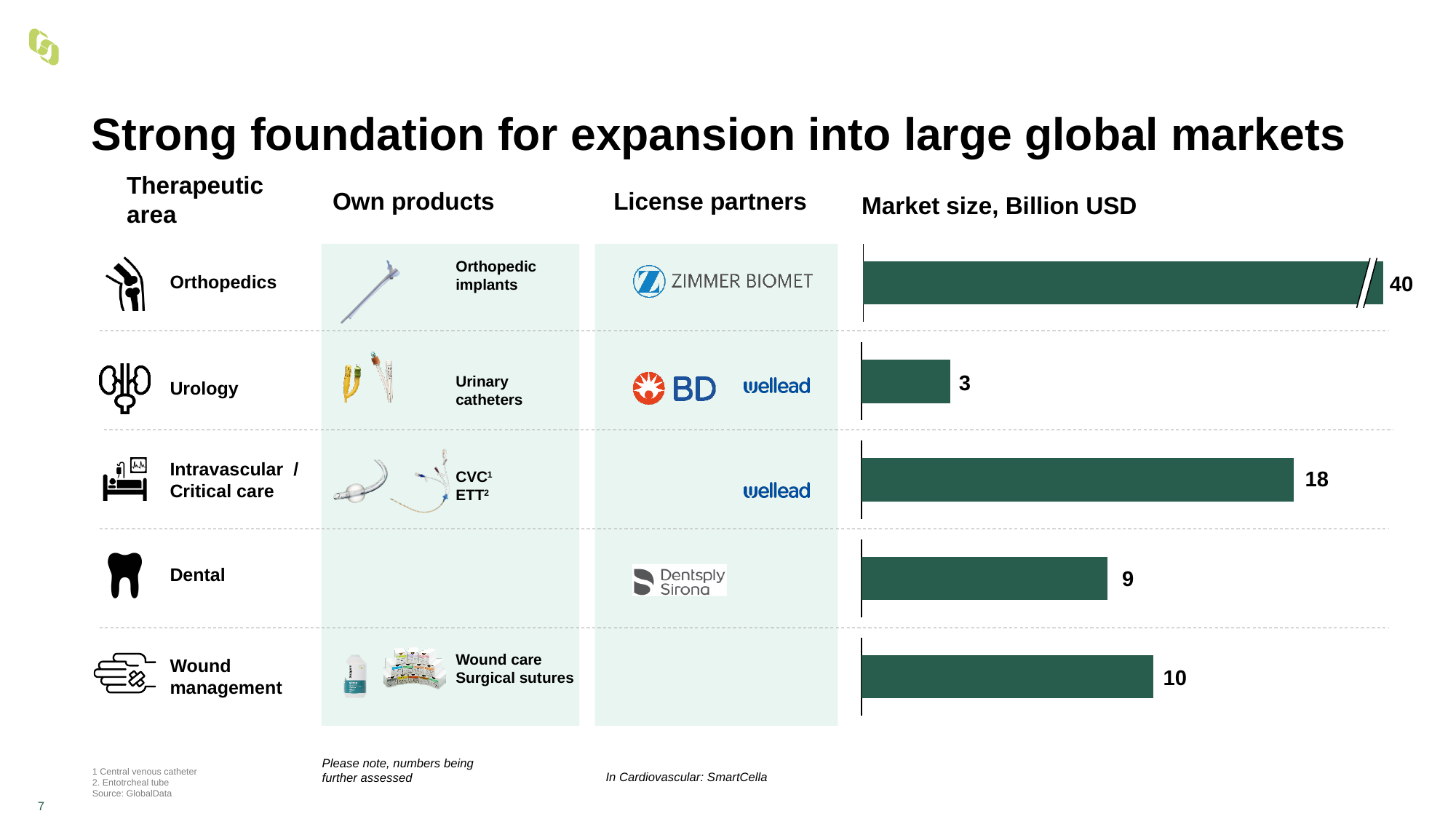
What is the market size for Wound management, in billion USD? 10 How many therapeutic areas are shown in the market size chart? 5 What is the market size for Intravascular / Critical care, in billion USD? 18 Which has a larger market size, Dental or Wound management? Wound management What is the difference in market size between Orthopedics and Intravascular / Critical care, in billion USD? 22 Which therapeutic area has the largest market size? Orthopedics What is the market size for Dental, in billion USD? 9 What is the market size for Orthopedics, in billion USD? 40 Which therapeutic area has the smallest market size? Urology What is the market size for Urology, in billion USD? 3 What kind of chart is used to show market size? Bar chart What is the title of the market size chart? Market size, Billion USD